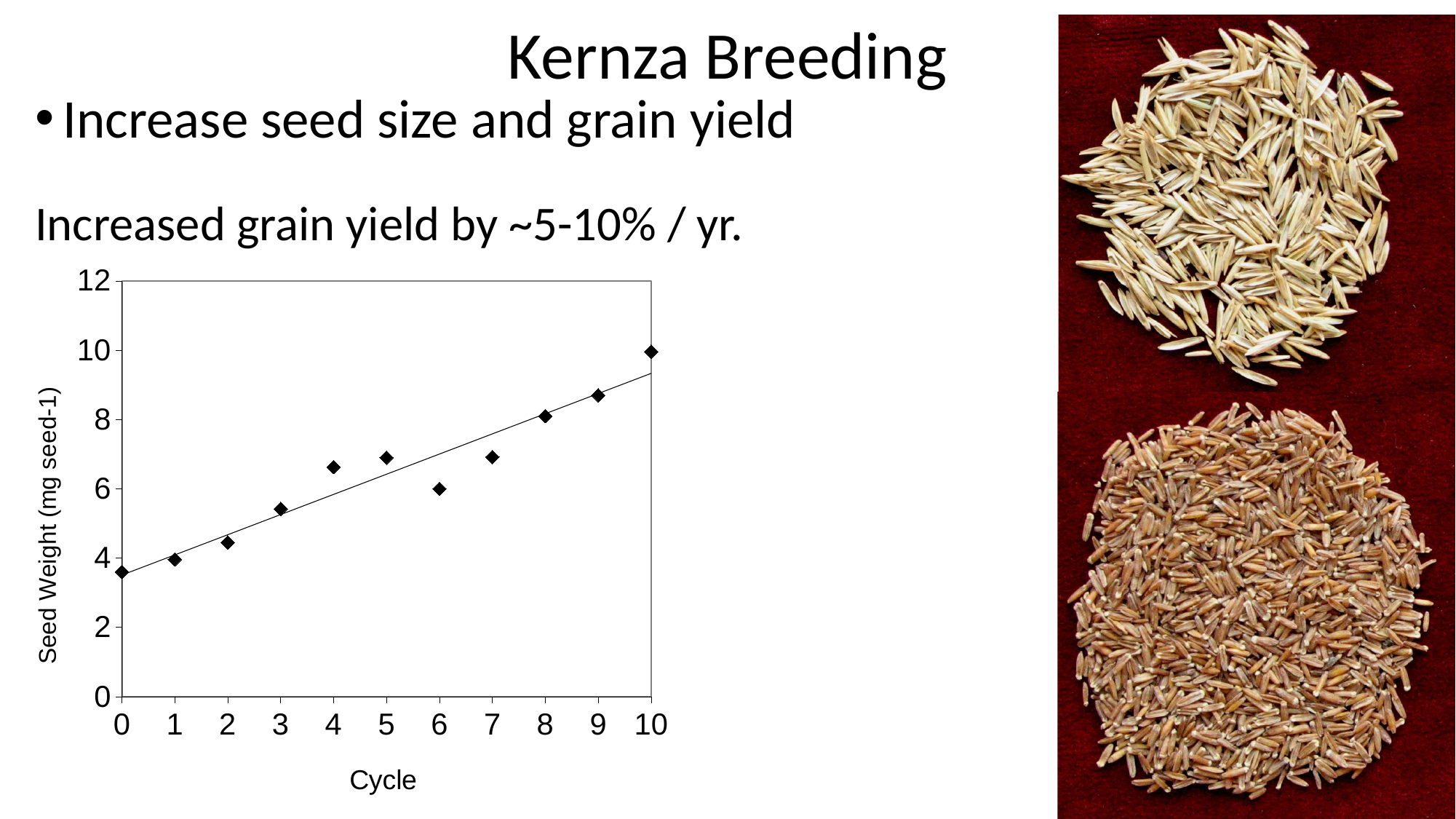
What is the title of the y axis of the chart? Seed Weight (mg seed-1) What is the title of the x axis of the chart? Cycle Do seed weight values generally rise or fall as the cycle number increases? rise Is the seed weight for cycle 9 greater or less than 8? greater How many data points are plotted in the chart? 11 Which has the higher seed weight, cycle 4 or cycle 6? cycle 4 Is the seed weight for cycle 0 greater or less than 4? less Which has the higher seed weight, cycle 8 or cycle 9? cycle 9 Which cycle has the lowest seed weight? 0 What kind of chart is shown on the slide? scatter plot Is the seed weight for cycle 3 greater or less than 4? greater Which cycle has the highest seed weight? 10